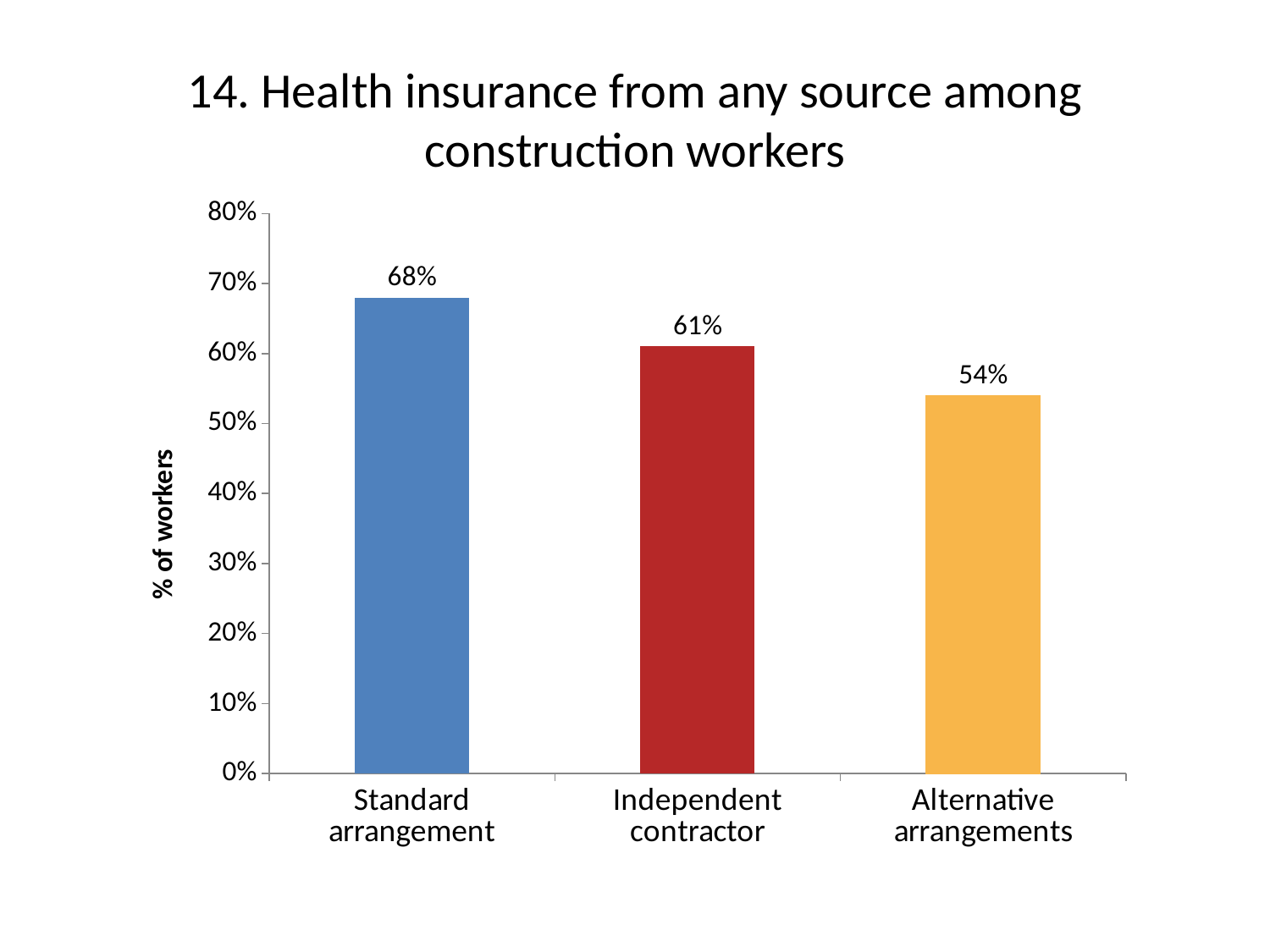
What kind of chart is shown on the slide? Bar chart What is the label of the vertical axis? % of workers What percentage of workers in alternative arrangements have health insurance? 54% Which category has the lowest percentage of workers with health insurance? Alternative arrangements Which is larger, the value for independent contractor or the value for alternative arrangements? Independent contractor What is the value shown for independent contractors? 61% What is the difference in percentage points between standard arrangement and alternative arrangements? 14 percentage points How many categories are shown on the x axis? 3 What percentage of workers in a standard arrangement have health insurance from any source? 68% Is the value for alternative arrangements greater or less than 60%? less What is the difference between the independent contractor value and the alternative arrangements value? 7 percentage points Which category has the highest percentage of workers with health insurance? Standard arrangement